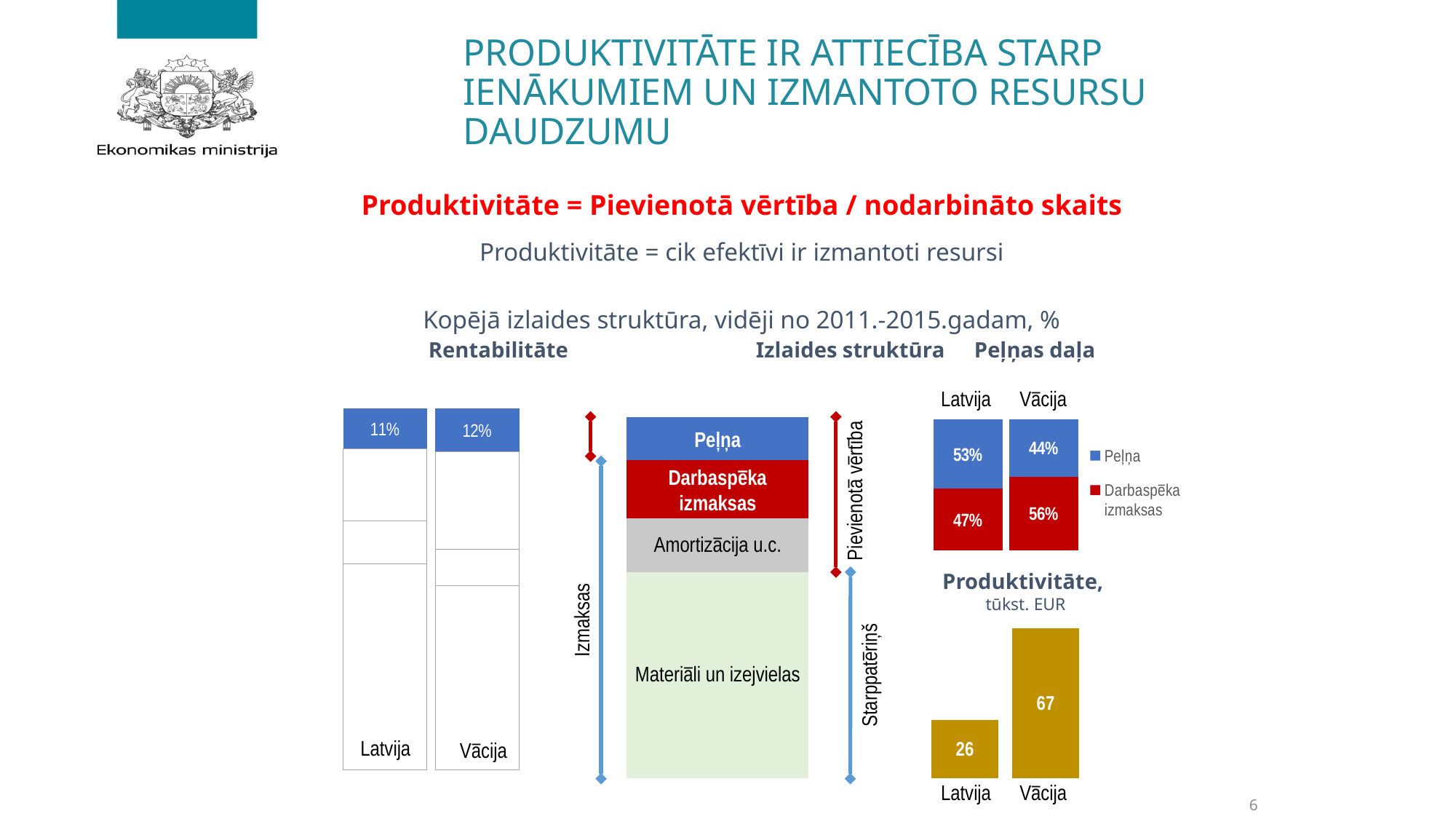
In the "Rentabilitāte" chart, what is the labelled top segment value for Vācija? 12% In the "Peļņas daļa" chart, what is the Peļņa share for Vācija? 44% In the "Peļņas daļa" chart, which country has the larger Darbaspēka izmaksas share? Vācija In the "Produktivitāte, tūkst. EUR" chart, what is the value for Vācija? 67 In the "Peļņas daļa" chart, what is the Darbaspēka izmaksas share for Vācija? 56% In the "Produktivitāte, tūkst. EUR" chart, which country has the higher value? Vācija In the "Produktivitāte, tūkst. EUR" chart, what is the difference between the values for Vācija and Latvija? 41 In the "Peļņas daļa" chart, how many series does the legend list? 2 In the "Peļņas daļa" chart, what is the Peļņa share for Latvija? 53% In the "Produktivitāte, tūkst. EUR" chart, how many countries are shown? 2 In the "Produktivitāte, tūkst. EUR" chart, what is the value for Latvija? 26 What kind of chart is the "Produktivitāte, tūkst. EUR" chart? Bar chart